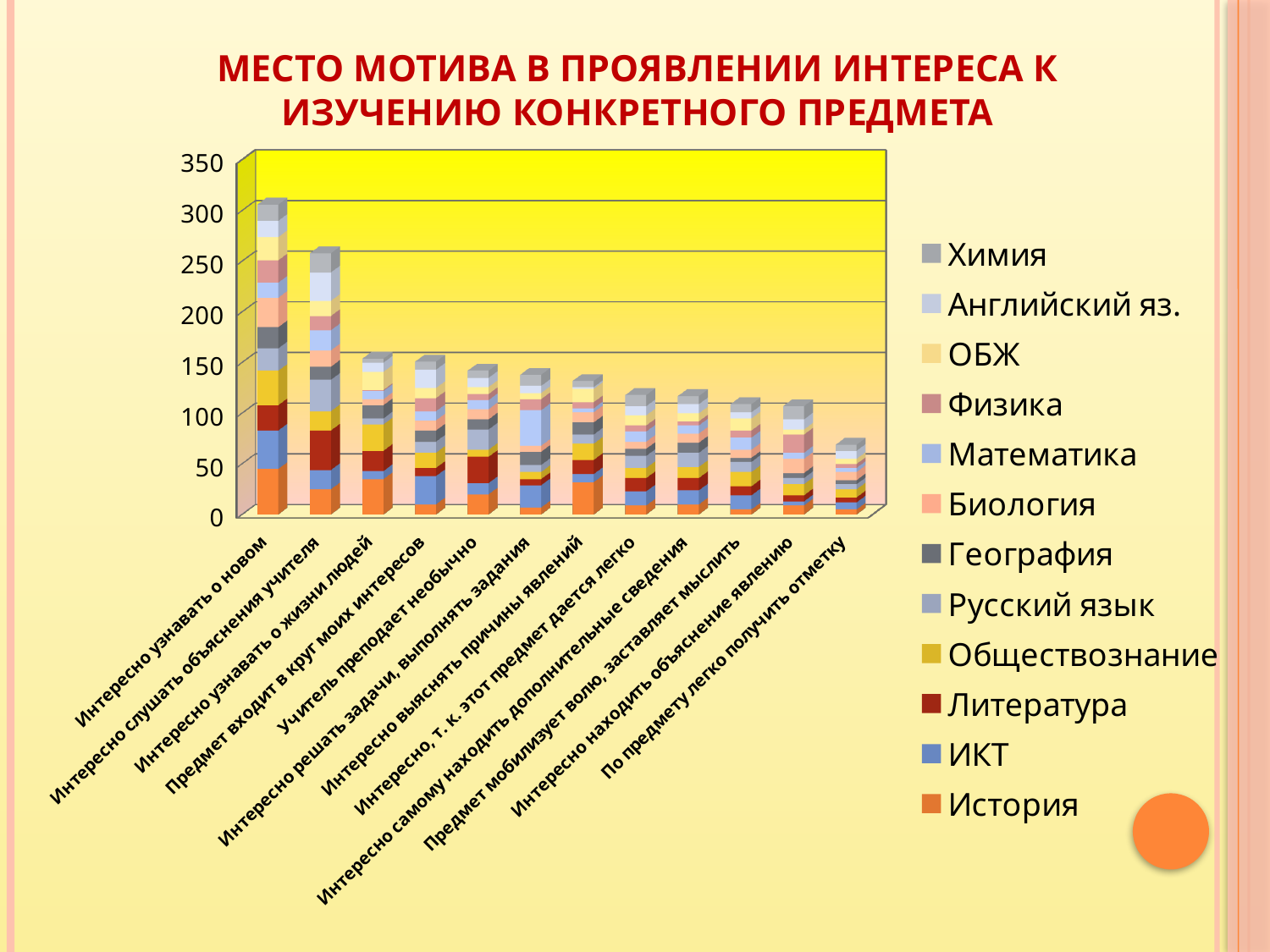
Which subject is listed first (at the top) in the legend? Химия What colour represents the series "История" in the chart? Orange Do the total stacked values rise or fall moving from left to right along the x axis? fall How many categories (motives) are shown along the x axis? 12 Which category has the highest total stacked value? Интересно узнавать о новом Is the total value for "По предмету легко получить отметку" greater or less than 100? less Which has the larger total: "Интересно узнавать о новом" or "Интересно слушать объяснения учителя"? Интересно узнавать о новом Which category has the lowest total stacked value? По предмету легко получить отметку How many series (subjects) does the legend list? 12 What kind of chart is shown on the slide? Stacked bar chart Is the total value for "Интересно, т.к. этот предмет дается легко" greater or less than 150? less Is the total value for "Интересно узнавать о новом" greater or less than 250? greater